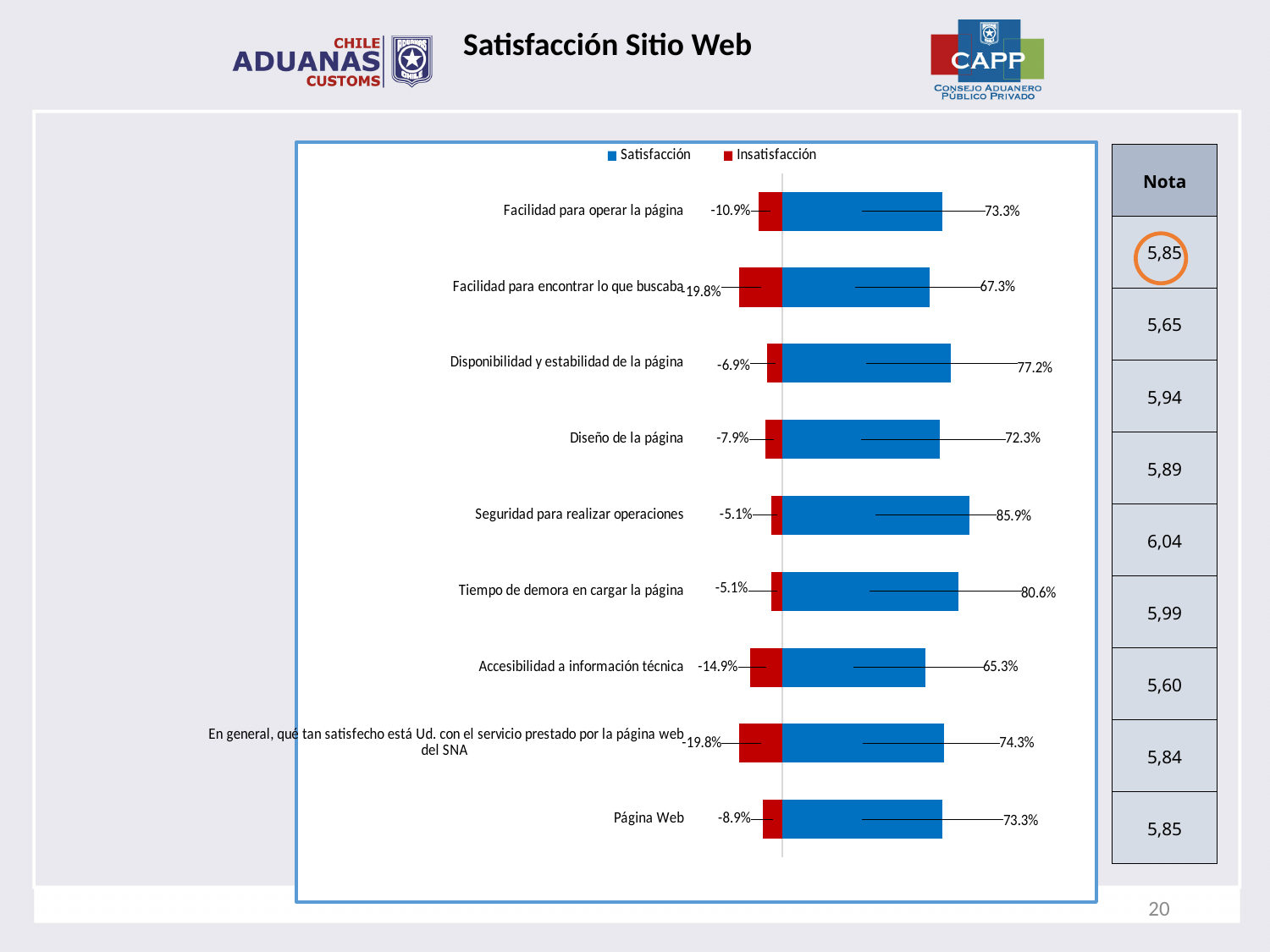
What is the difference between the Satisfacción values for "Seguridad para realizar operaciones" and "Tiempo de demora en cargar la página"? 5.3 percentage points How many categories are shown in the chart? 9 How many series does the legend list? 2 What kind of chart is shown on the slide? Bar chart Which category has the lowest Satisfacción value? Accesibilidad a información técnica What is the Insatisfacción value for "Accesibilidad a información técnica"? -14.9% Which category has the highest Satisfacción value? Seguridad para realizar operaciones Which has a higher Satisfacción value: "Disponibilidad y estabilidad de la página" or "Diseño de la página"? Disponibilidad y estabilidad de la página What is the Satisfacción value for "Seguridad para realizar operaciones"? 85.9% What are the two series named in the chart legend? Satisfacción and Insatisfacción What is the Satisfacción value for "Tiempo de demora en cargar la página"? 80.6% What is the Insatisfacción value for "Facilidad para encontrar lo que buscaba"? -19.8%